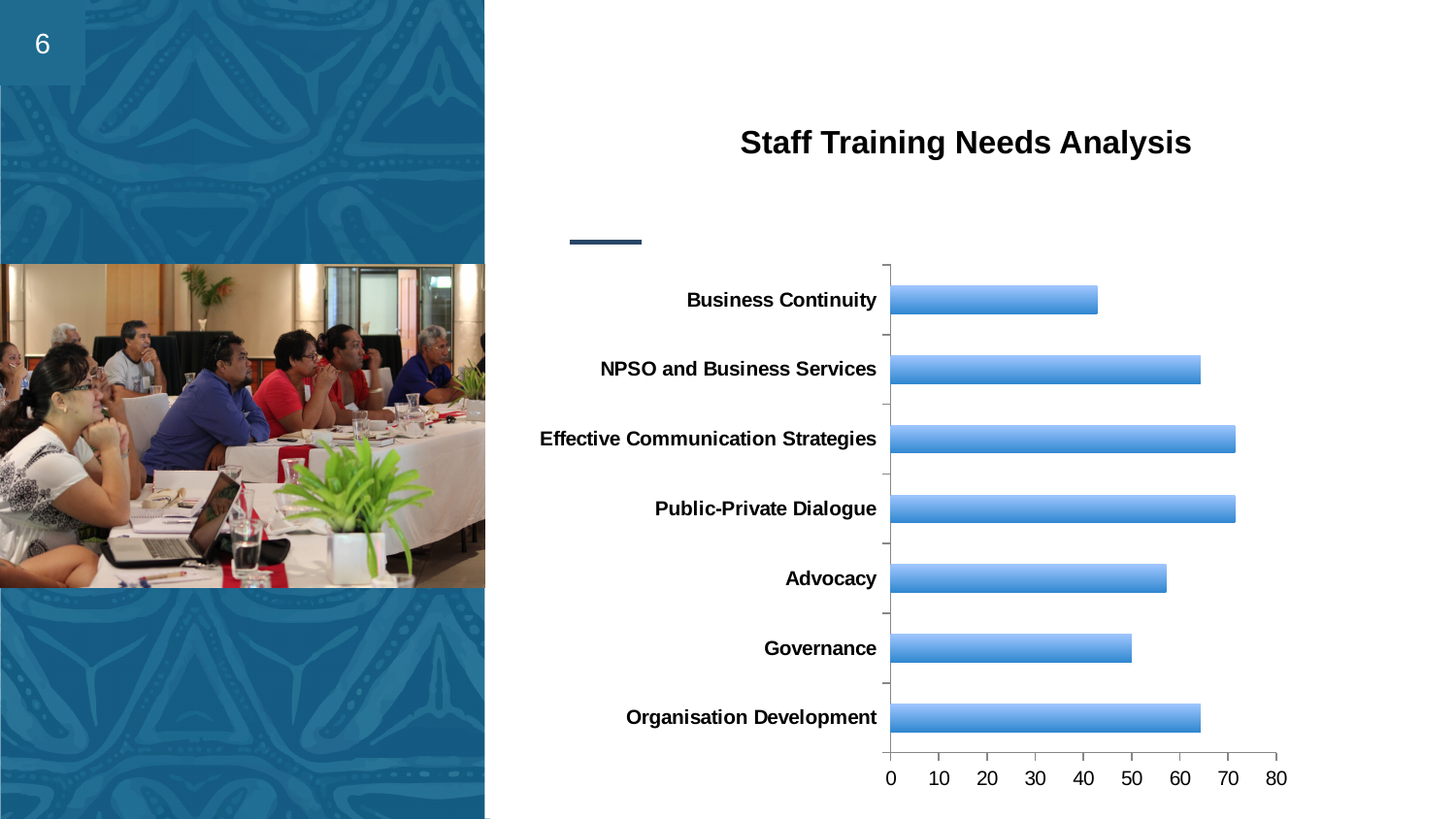
Is the value for Business Continuity greater or less than 50? less Which is larger, the value for Advocacy or the value for Business Continuity? Advocacy Is the value for Organisation Development greater or less than 60? greater Is the value for Public-Private Dialogue greater or less than 60? greater What is the title of the chart? Staff Training Needs Analysis Which category has the lowest value? Business Continuity Which is larger, the value for Governance or the value for NPSO and Business Services? NPSO and Business Services How many categories are plotted in the chart? 7 What kind of chart is shown on the slide? Bar chart What is the highest value shown on the horizontal axis? 80